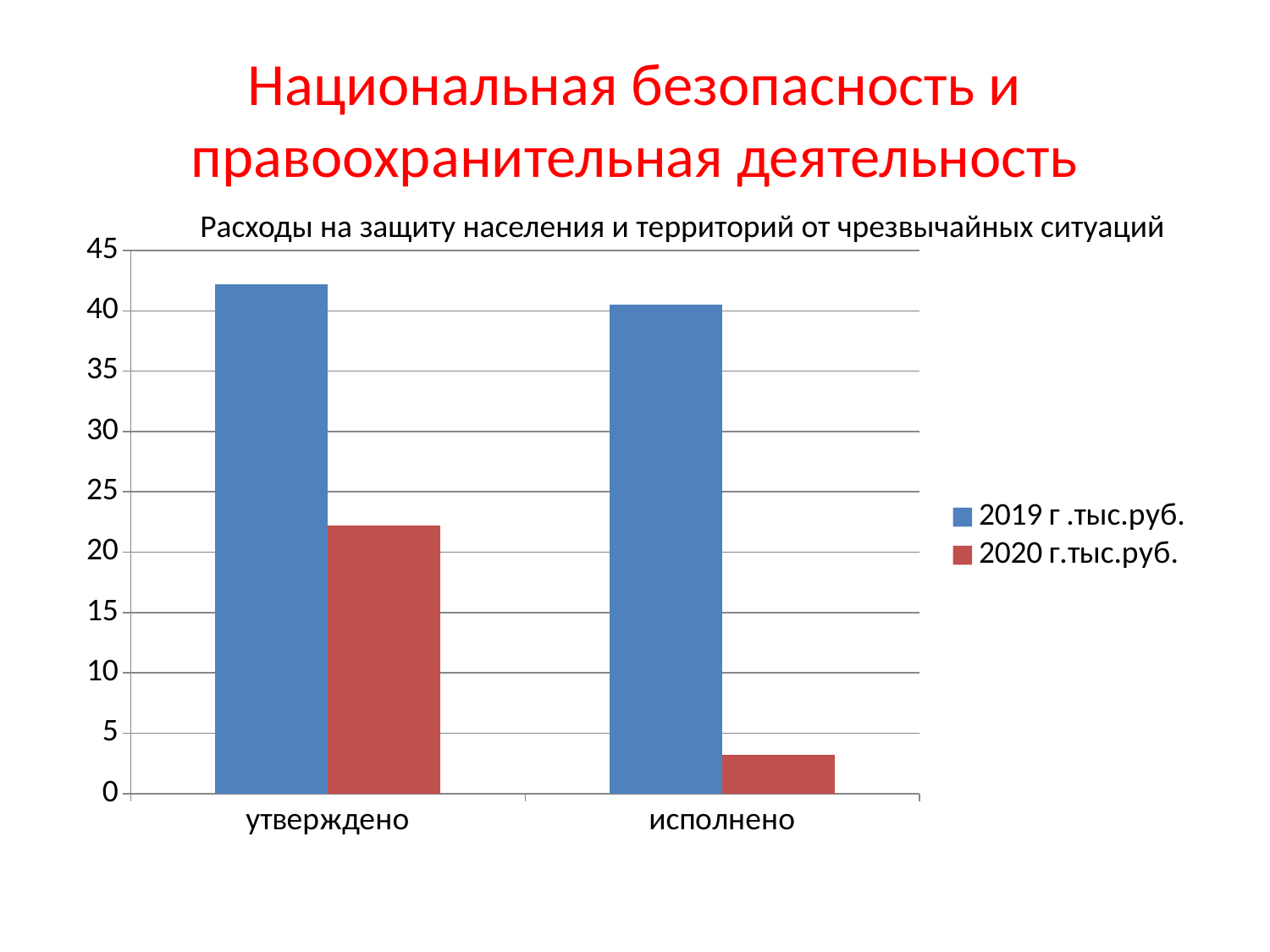
Is the value for 2019 г .тыс.руб. in the утверждено category greater or less than 40? greater How many series does the legend list? 2 What kind of chart is shown on the slide? bar chart Which bar is the highest in the chart? 2019 г .тыс.руб. in утверждено Which series is shown in red? 2020 г.тыс.руб. How many categories are shown on the x axis? 2 Is the value for 2019 г .тыс.руб. in the исполнено category greater or less than 35? greater Is the value for 2020 г.тыс.руб. in the исполнено category greater or less than 5? less Which bar is the lowest in the chart? 2020 г.тыс.руб. in исполнено What is the title of the chart? Расходы на защиту населения и территорий от чрезвычайных ситуаций Which is larger in the исполнено category: 2019 г .тыс.руб. or 2020 г.тыс.руб.? 2019 г .тыс.руб.